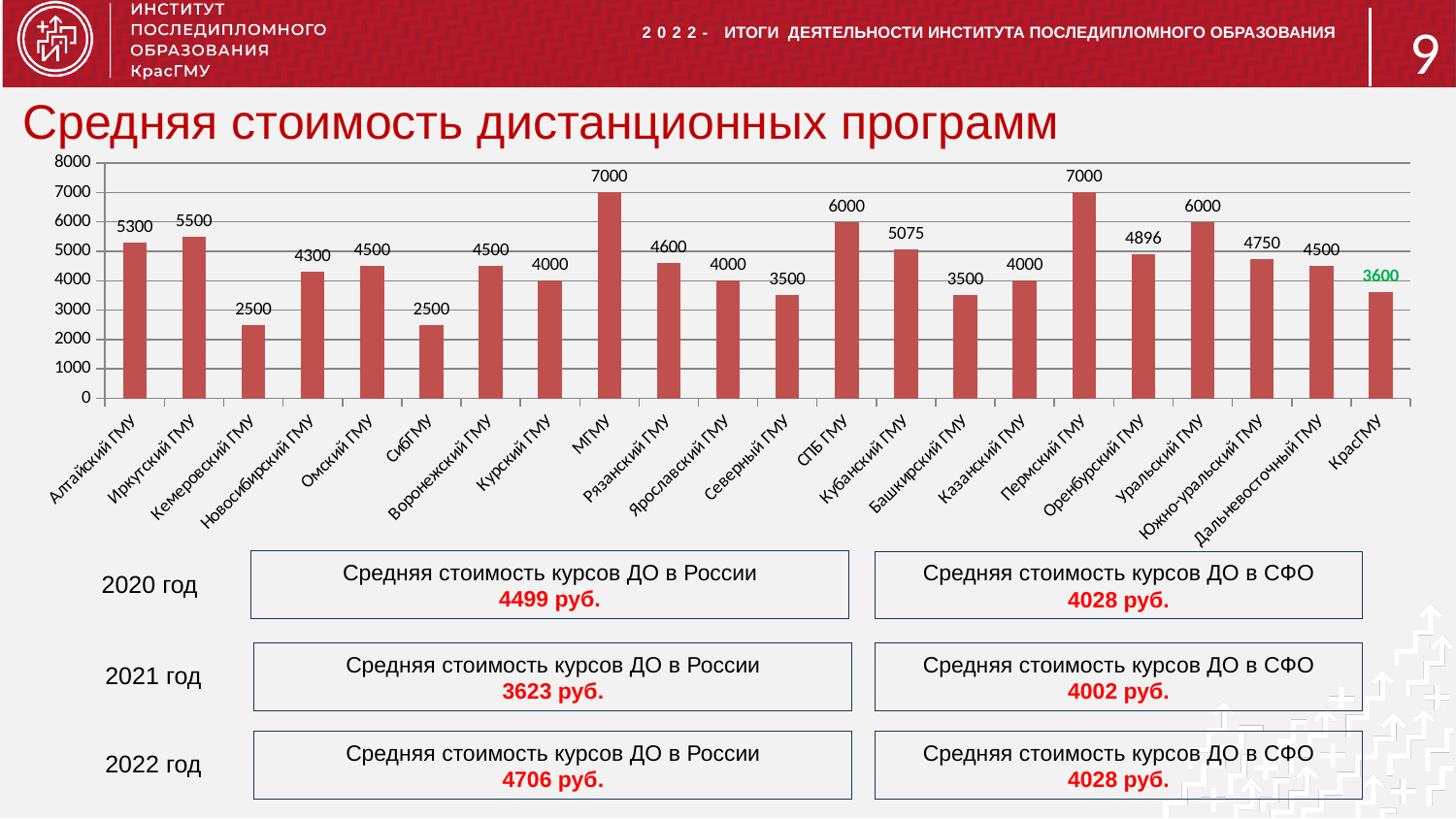
What is the value for Новосибирский ГМУ? 4300 What is the title of the chart? Средняя стоимость дистанционных программ What is the lowest value shown on the chart? 2500 What kind of chart is shown on the slide? Bar chart What is the value for Оренбургский ГМУ? 4896 What is the highest value shown on the chart? 7000 Which is larger, the value for СПб ГМУ or the value for Рязанский ГМУ? СПб ГМУ What is the value for Кубанский ГМУ? 5075 How many categories are shown on the x axis of the chart? 22 What is the value for КрасГМУ? 3600 What is the difference between the values for МГМУ and Кемеровский ГМУ? 4500 What is the difference between the values for Иркутский ГМУ and Алтайский ГМУ? 200